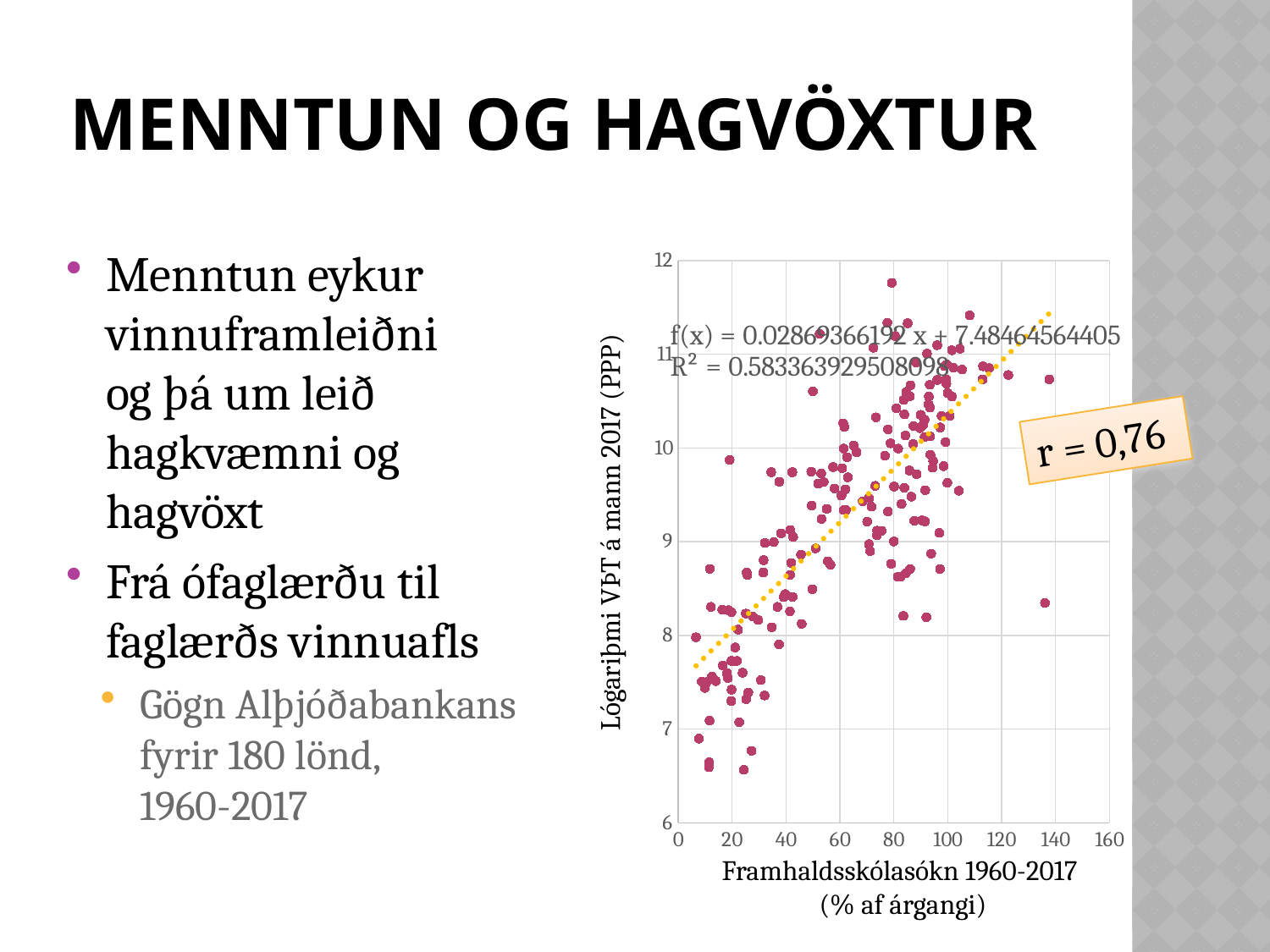
What is the title of the x axis? Framhaldsskólasókn 1960-2017 (% af árgangi) What correlation coefficient (r) is shown on the chart? r = 0,76 What is the highest tick value shown on the x axis? 160 What is the lowest tick value shown on the y axis? 6 What kind of chart is shown on the slide? scatter chart What is the title of the y axis? Lógariþmi VÞT á mann 2017 (PPP) What is the intercept of the fitted line equation shown on the chart? 7.48464564405 Do the plotted values generally rise or fall as the x-axis value increases? rise Is the slope of the fitted line positive or negative? positive Is the R² value shown on the chart greater or less than 0.5? greater